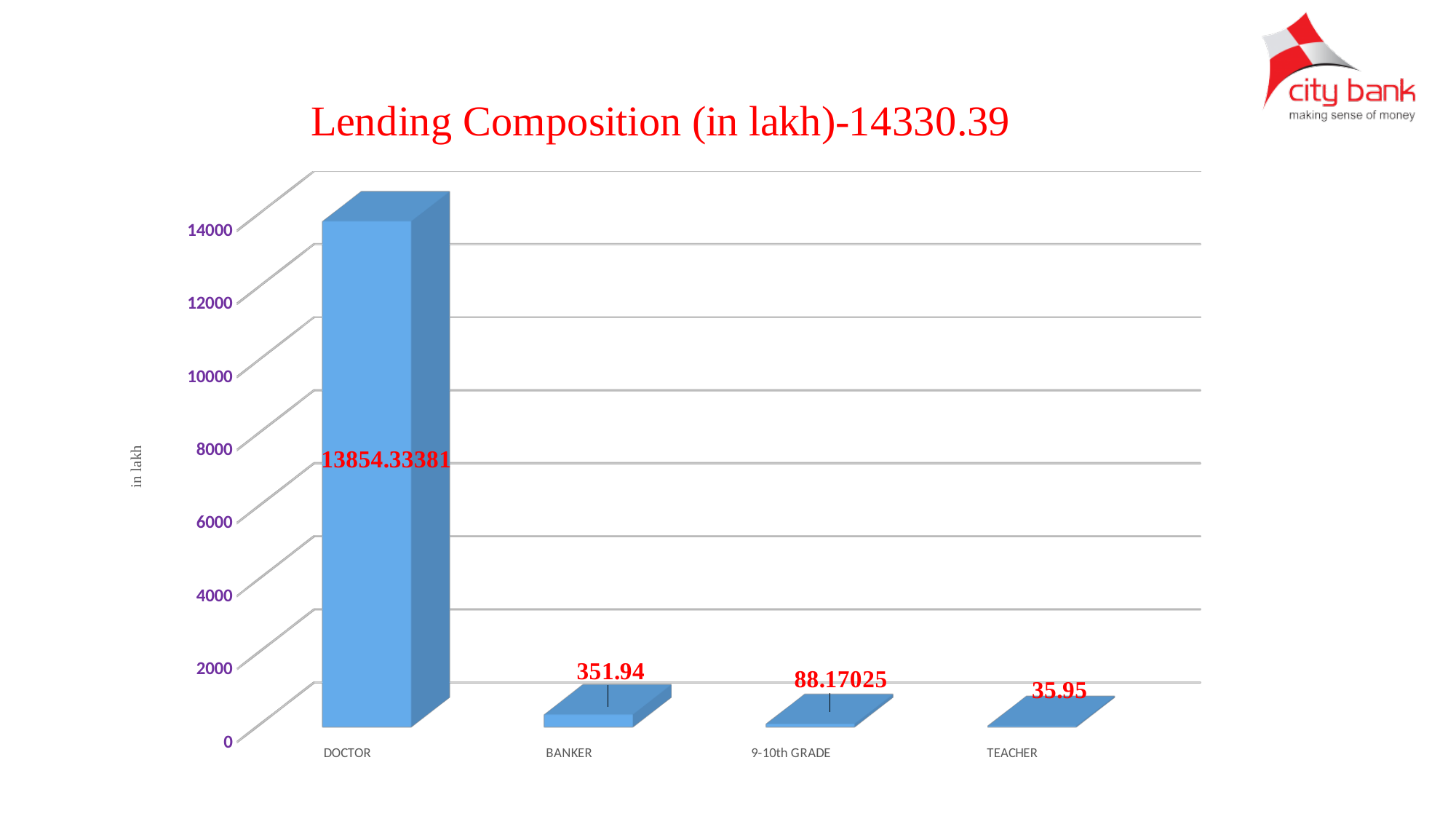
Which is larger, the value for BANKER or the value for 9-10th GRADE? BANKER What is the value for TEACHER? 35.95 What is the title of the chart? Lending Composition (in lakh)-14330.39 Which category has the highest value? DOCTOR What is the value for 9-10th GRADE? 88.17025 What is the value for BANKER? 351.94 How many categories are shown on the x axis? 4 What is the value for DOCTOR? 13854.33381 What is the difference between the values for BANKER and TEACHER? 315.99 Is the value for DOCTOR greater or less than 12000? greater What kind of chart is shown on the slide? bar chart Which category has the lowest value? TEACHER